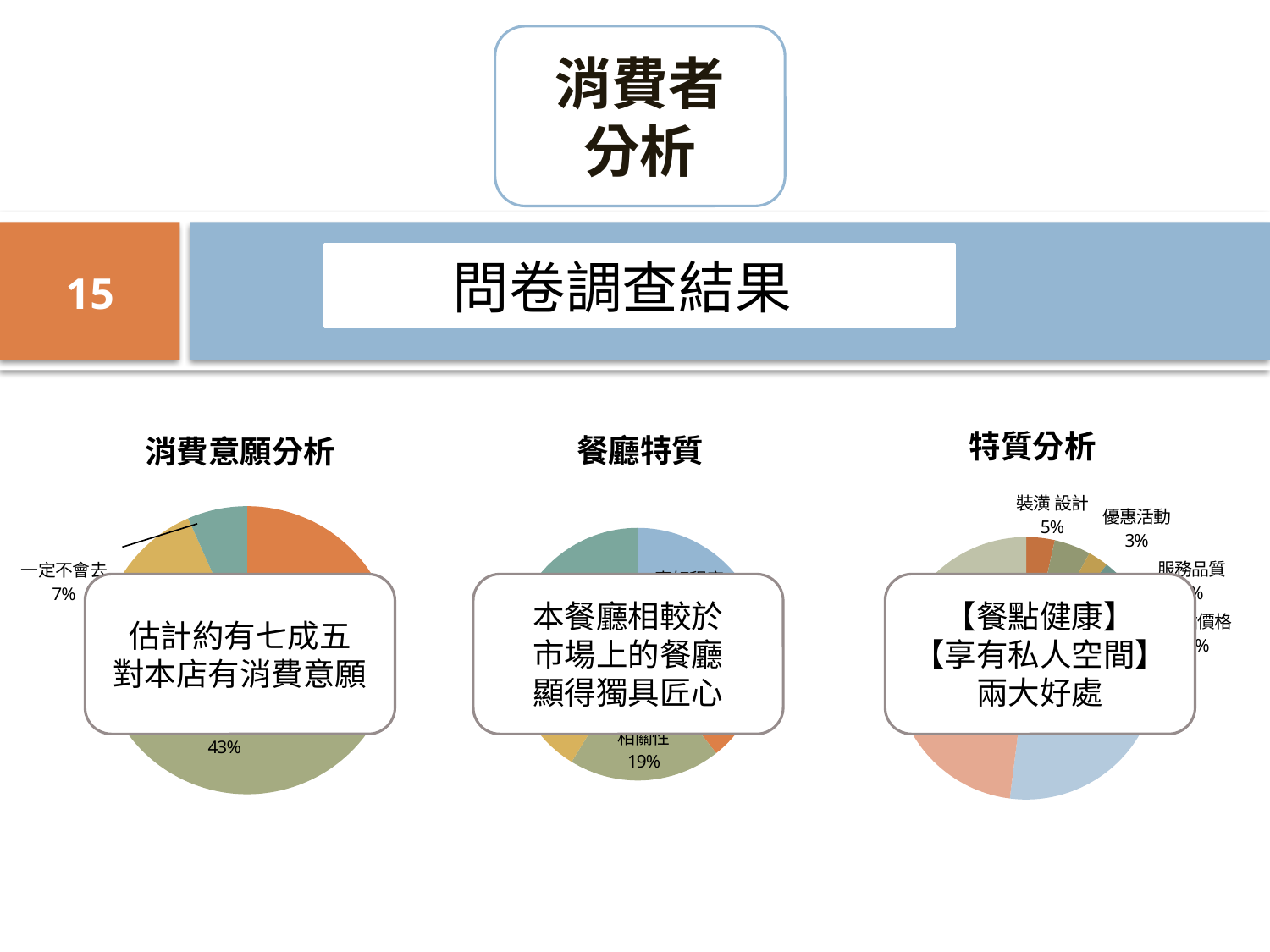
What is the title of the middle chart on the slide? 餐廳特質 In the 特質分析 chart, what is the difference between the shares of 裝潢 設計 and 優惠活動? 2% What kind of chart is the 特質分析 chart? pie chart In the 特質分析 chart, what percentage is shown for 優惠活動? 3% In the 特質分析 chart, which has the larger share, 裝潢 設計 or 優惠活動? 裝潢 設計 In the 消費意願分析 chart, what percentage is shown for 一定不會去? 7% What kind of chart is the 消費意願分析 chart? pie chart In the 特質分析 chart, what percentage is shown for 裝潢 設計? 5% How many pie charts are shown on the slide? 3